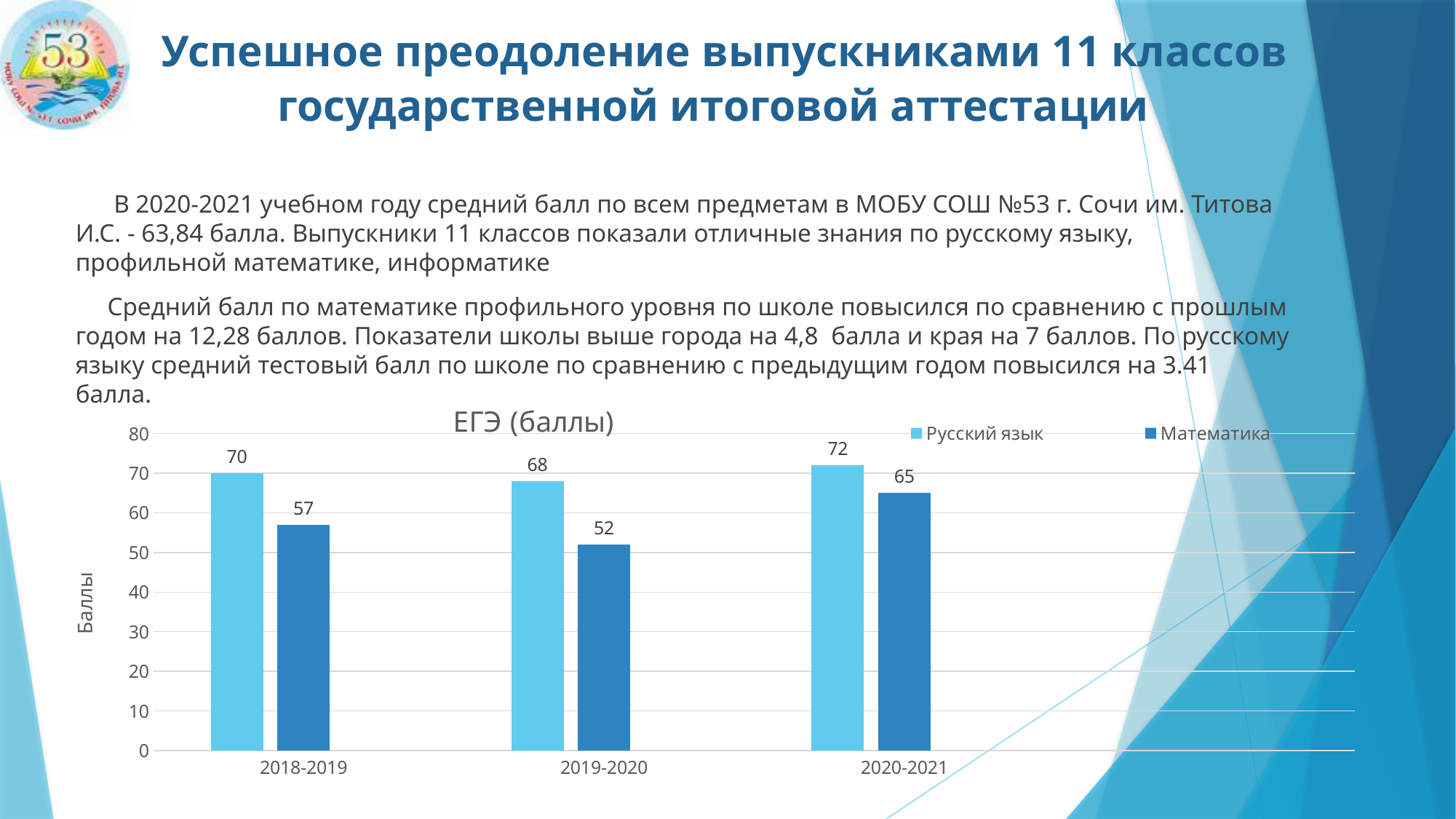
What is the difference between the Русский язык and Математика values in 2018-2019? 13 How many series does the legend list? 2 Which is larger in 2019-2020: Русский язык or Математика? Русский язык What kind of chart is shown on the slide? Bar chart What is the title of the chart? ЕГЭ (баллы) In which year is the Русский язык value highest? 2020-2021 In which year is the Математика value lowest? 2019-2020 How many year categories are shown on the x axis? 3 What is the value for Математика in 2020-2021? 65 What is the value for Математика in 2019-2020? 52 By how much did the Математика value increase from 2019-2020 to 2020-2021? 13 What is the value for Русский язык in 2018-2019? 70